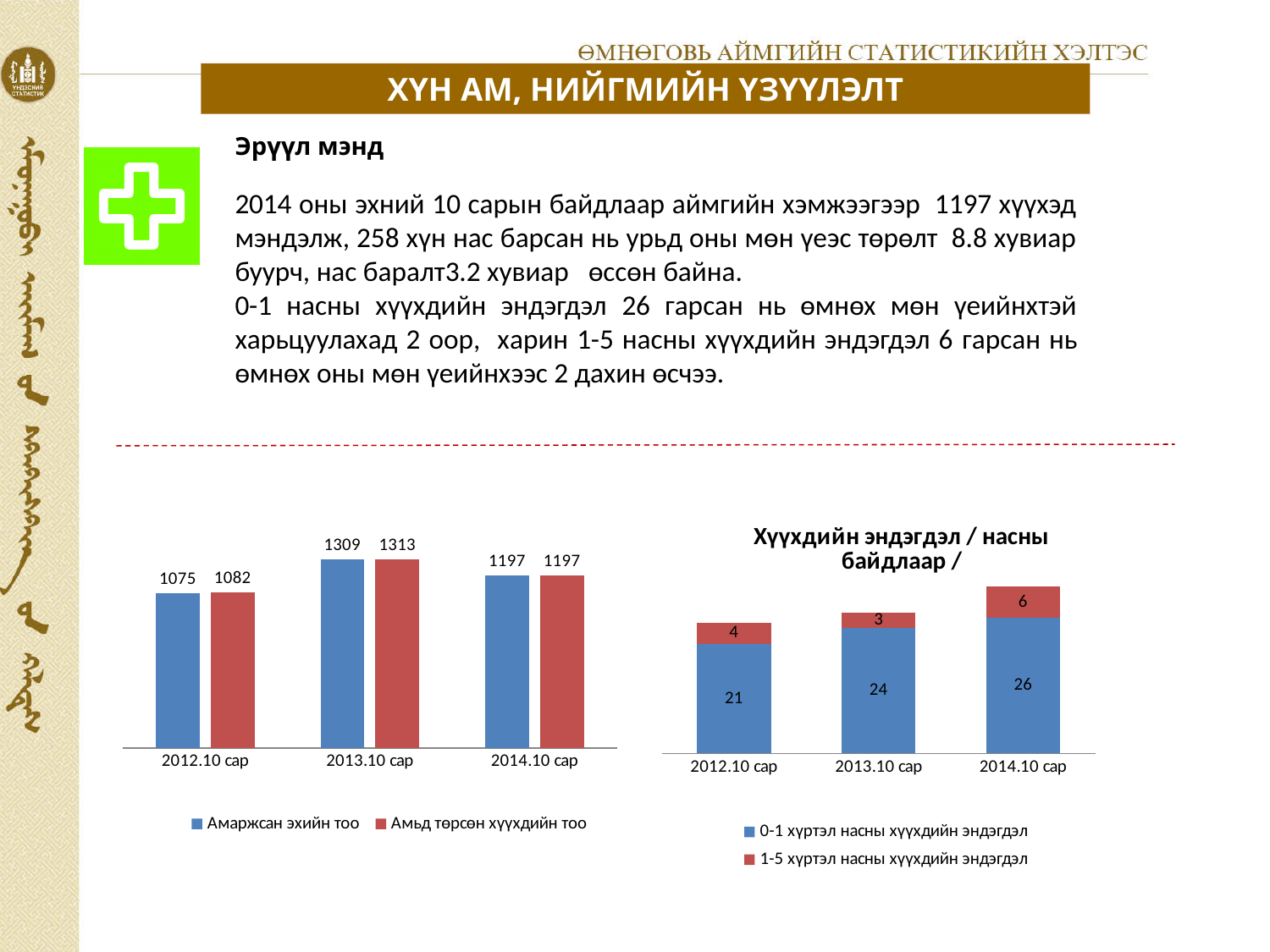
What kind of chart is the chart titled 'Хүүхдийн эндэгдэл / насны байдлаар /'? stacked bar chart In the chart titled 'Хүүхдийн эндэгдэл / насны байдлаар /', what is the value of 0-1 хүртэл насны хүүхдийн эндэгдэл for 2014.10 сар? 26 In the chart titled 'Хүүхдийн эндэгдэл / насны байдлаар /', what is the value of 1-5 хүртэл насны хүүхдийн эндэгдэл for 2013.10 сар? 3 In the left chart, what is the value of Амьд төрсөн хүүхдийн тоо for 2013.10 сар? 1313 In the chart titled 'Хүүхдийн эндэгдэл / насны байдлаар /', what is the total of the stacked bar for 2012.10 сар? 25 In the chart titled 'Хүүхдийн эндэгдэл / насны байдлаар /', how many categories are shown on the x axis? 3 In the left chart, what is the difference between Амаржсан эхийн тоо in 2013.10 сар and in 2014.10 сар? 112 In the left chart, which category has the highest value for Амаржсан эхийн тоо? 2013.10 сар In the chart titled 'Хүүхдийн эндэгдэл / насны байдлаар /', does the value of 0-1 хүртэл насны хүүхдийн эндэгдэл rise or fall from 2012.10 сар to 2014.10 сар? rise In the left chart, which category has the lowest value for Амьд төрсөн хүүхдийн тоо? 2012.10 сар In the left chart, how many series does the legend list? 2 In the left chart, what is the value of Амаржсан эхийн тоо for 2012.10 сар? 1075